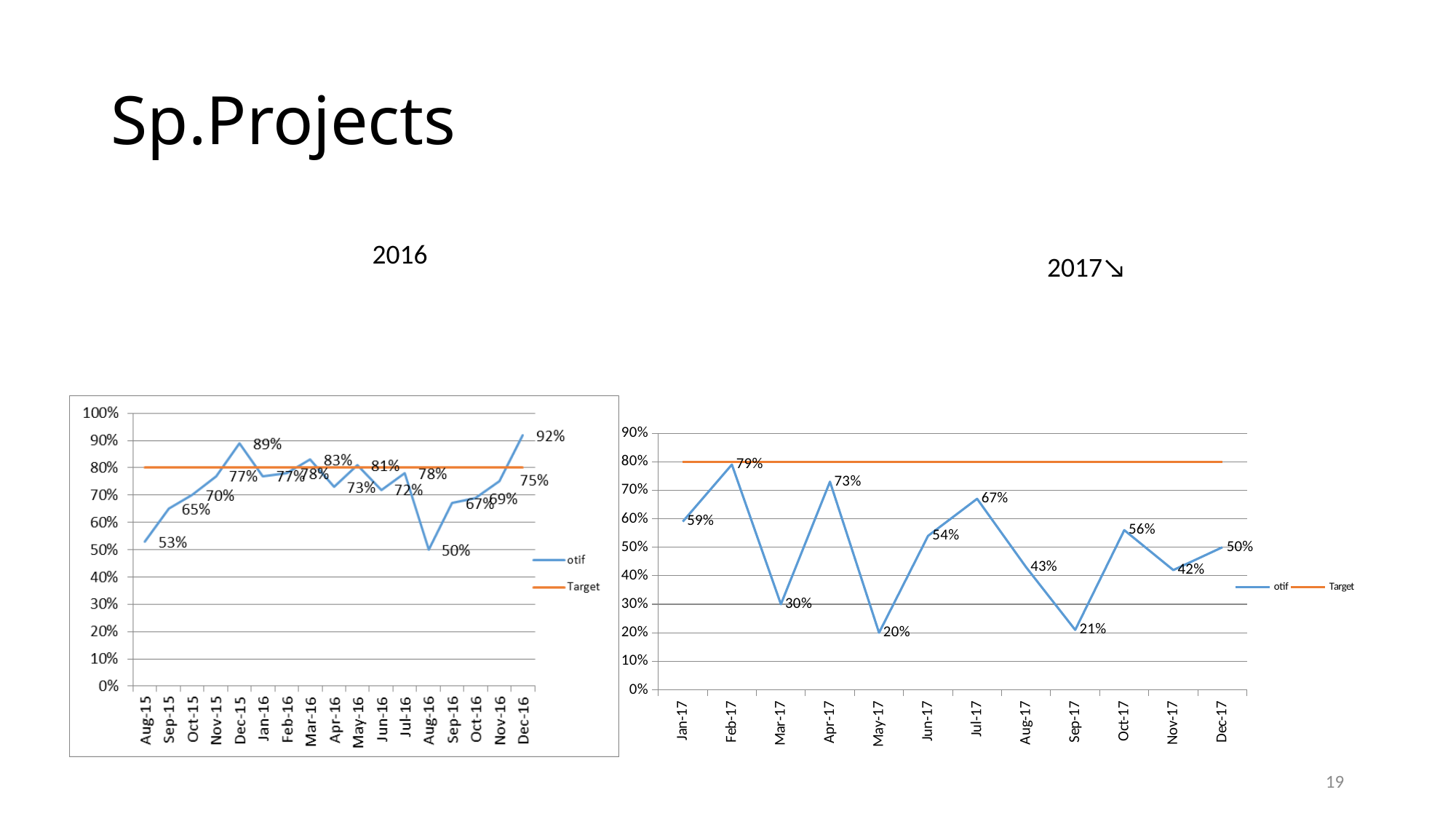
In the 2016 chart on the left, which month has the lowest otif value? Aug-16 In the 2017 chart on the right, what is the difference between the otif values for Apr-17 and Mar-17? 43% How many series does the legend of the 2016 chart on the left list? 2 In the 2017 chart on the right, what is the otif value for Feb-17? 79% In the 2017 chart on the right, how many months are plotted on the x axis? 12 In the 2017 chart on the right, which month has the lowest otif value? May-17 In the 2016 chart on the left, what is the otif value for Aug-15? 53% In the 2017 chart on the right, what is the otif value for May-17? 20% In the 2017 chart on the right, which is larger, the otif value for Jun-17 or Oct-17? Oct-17 In the 2017 chart on the right, which month has the highest otif value? Feb-17 In the 2016 chart on the left, what is the otif value for Dec-16? 92% What kind of chart is the 2017 chart on the right? Line chart